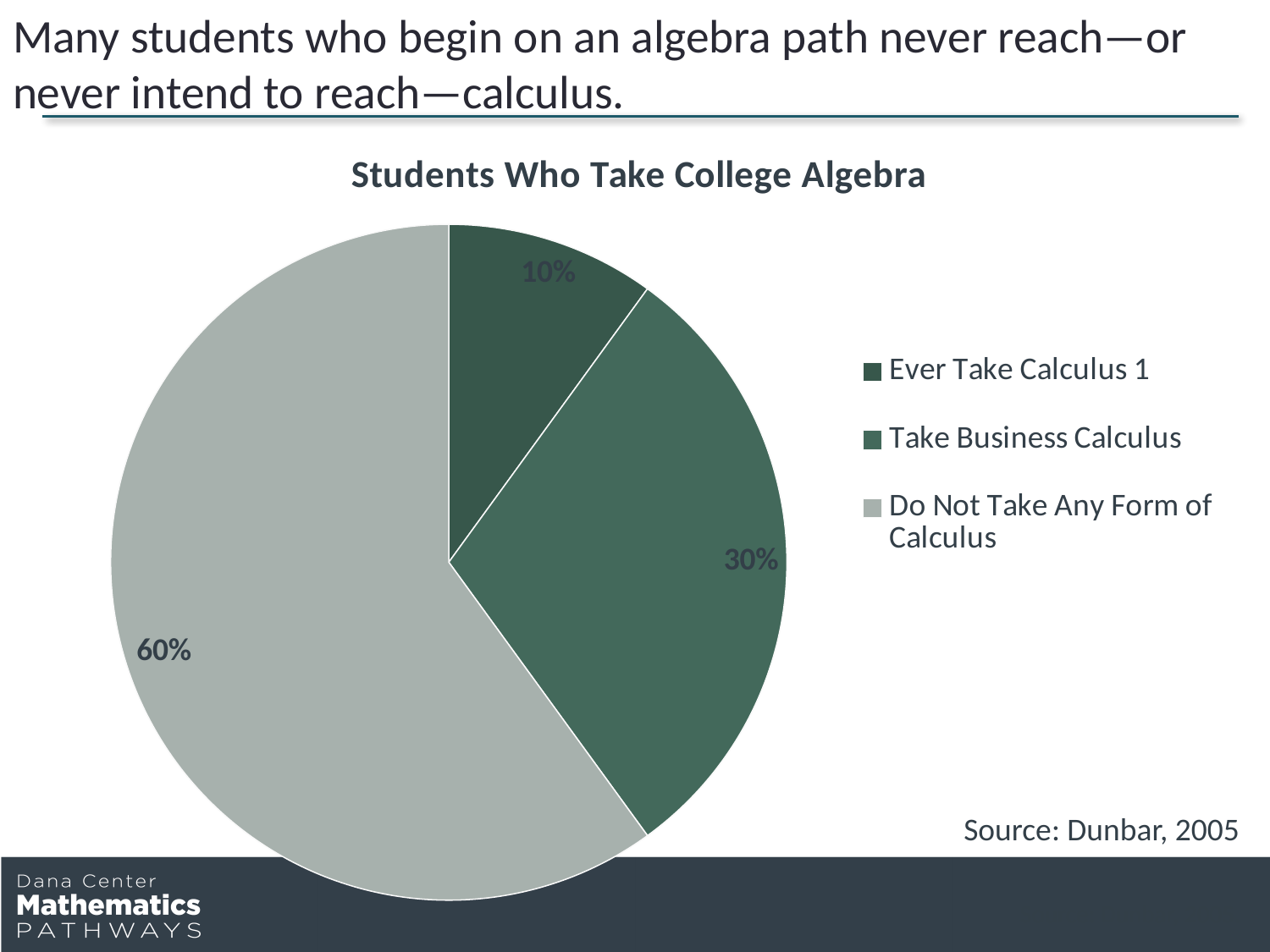
What is the combined share of students who take some form of calculus (Ever Take Calculus 1 plus Take Business Calculus)? 40% How many entries does the legend list? 3 Which is larger: the share for Take Business Calculus or the share for Ever Take Calculus 1? Take Business Calculus What percentage of students Ever Take Calculus 1? 10% Which category has the smallest share of the pie? Ever Take Calculus 1 What percentage of students Do Not Take Any Form of Calculus? 60% Which category has the largest share of the pie? Do Not Take Any Form of Calculus What is the difference in percentage points between Do Not Take Any Form of Calculus and Take Business Calculus? 30 What kind of chart is shown on the slide? pie chart What is the title of the chart? Students Who Take College Algebra What percentage of students Take Business Calculus? 30% How many slices does the pie chart have? 3